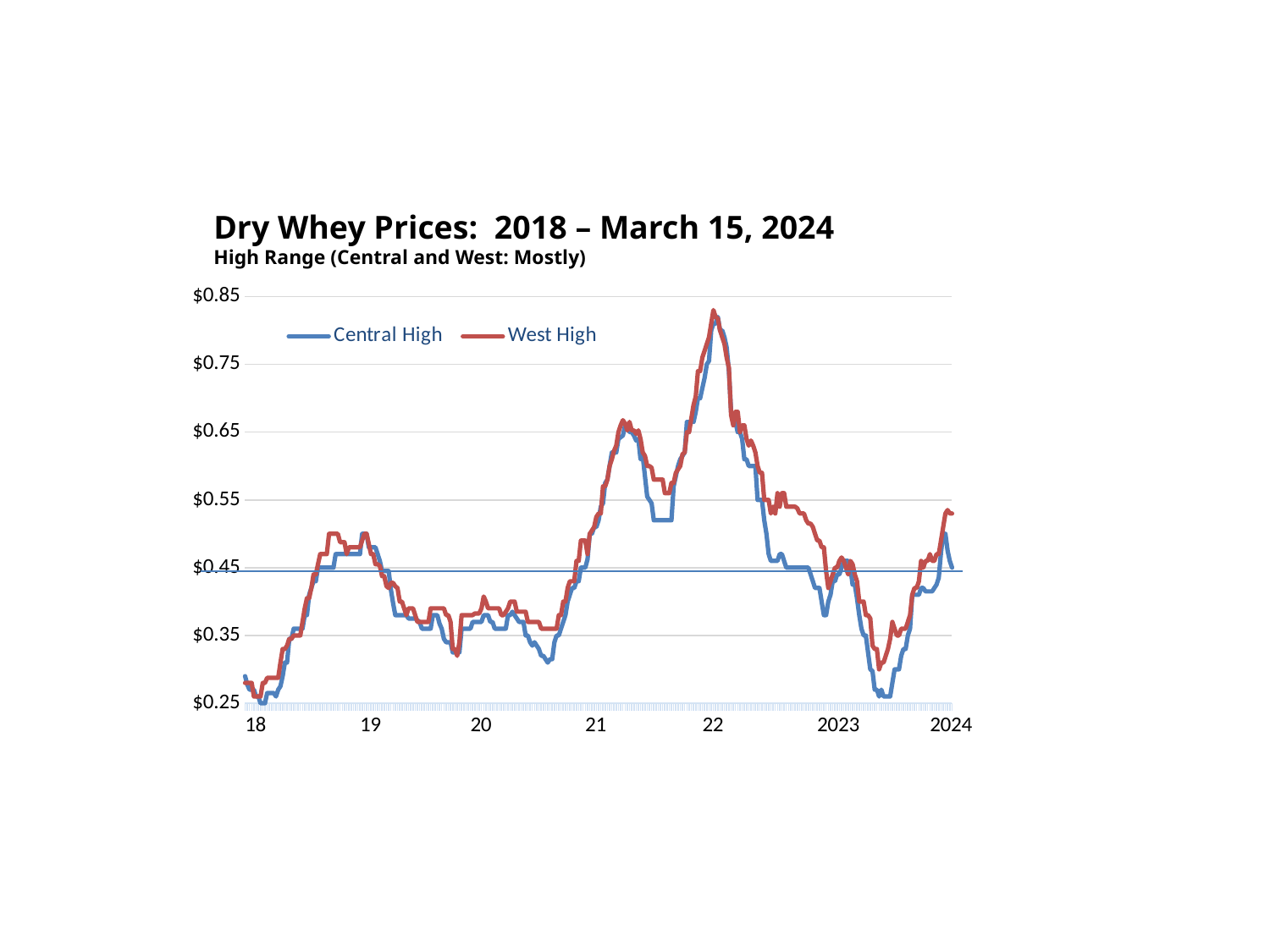
What is the title of the chart? Dry Whey Prices: 2018 – March 15, 2024 Is the West High value at the end of the series (March 2024) greater or less than $0.45? greater Is the lowest Central High value during 2023 greater or less than $0.35? less How many series does the legend list? 2 Do the prices rise or fall between the peak at 22 and the year label 2023? fall How many year labels are shown on the x axis? 7 Is the peak value of the West High series in early 2022 greater or less than $0.75? greater Do the prices rise or fall between the year label 18 and the year label 19? rise Which series is drawn in red? West High Around which year label on the x axis do both series reach their highest values? 22 What kind of chart is shown on the slide? line chart